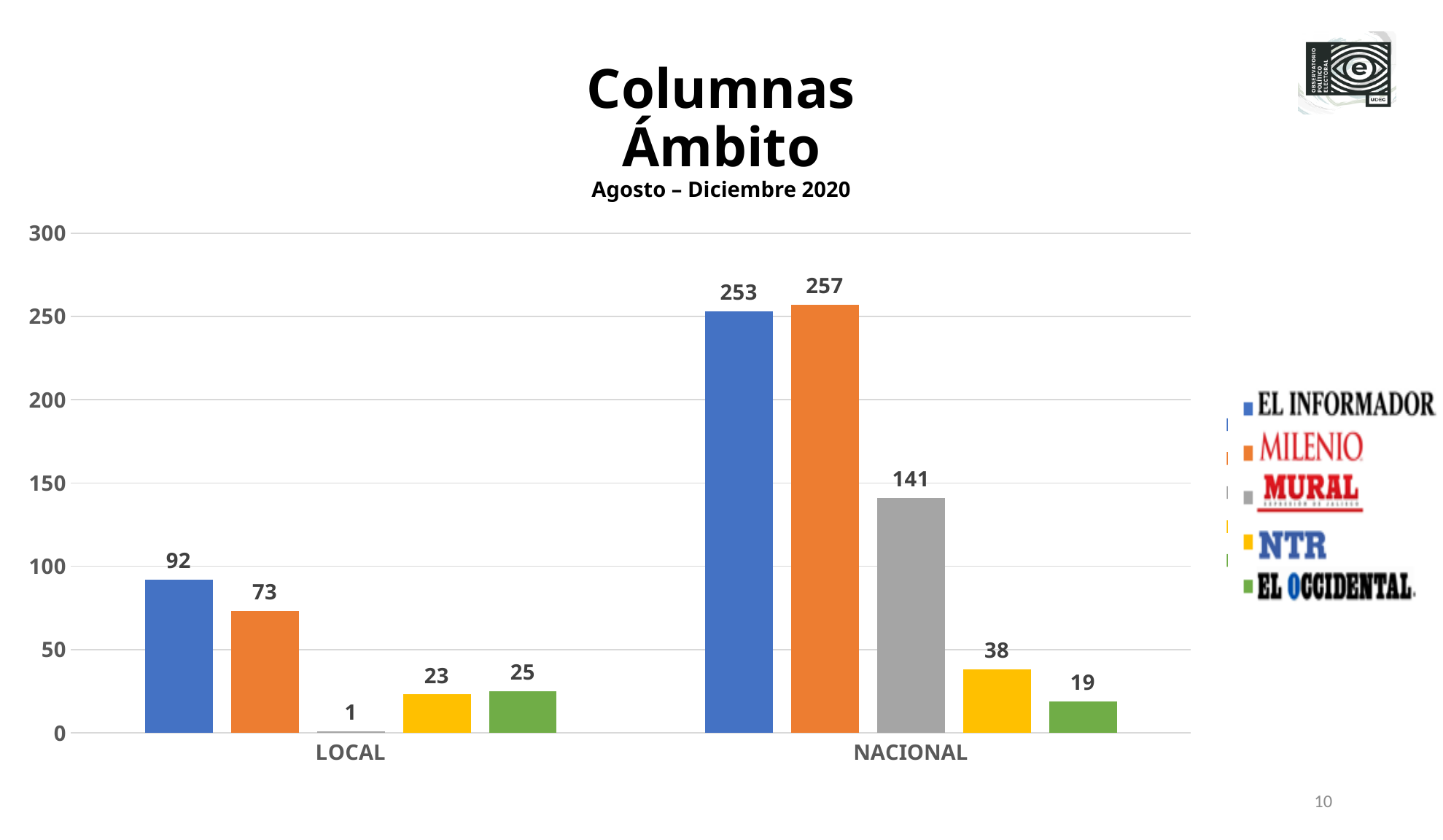
Which outlet has the lowest value in the LOCAL category? Mural What is the value for NTR in the NACIONAL category? 38 What is the difference between El Informador's NACIONAL and LOCAL values? 161 How many series does the legend list? 5 How many categories are shown on the x axis? 2 What is the value for Milenio in the NACIONAL category? 257 Which outlet has the highest value in the NACIONAL category? Milenio Which is larger in the LOCAL category: NTR or El Occidental? El Occidental What is the value for El Informador in the LOCAL category? 92 What kind of chart is shown on the slide? Bar chart Is the value for Mural in the NACIONAL category greater or less than 150? less What is the value for Mural in the LOCAL category? 1